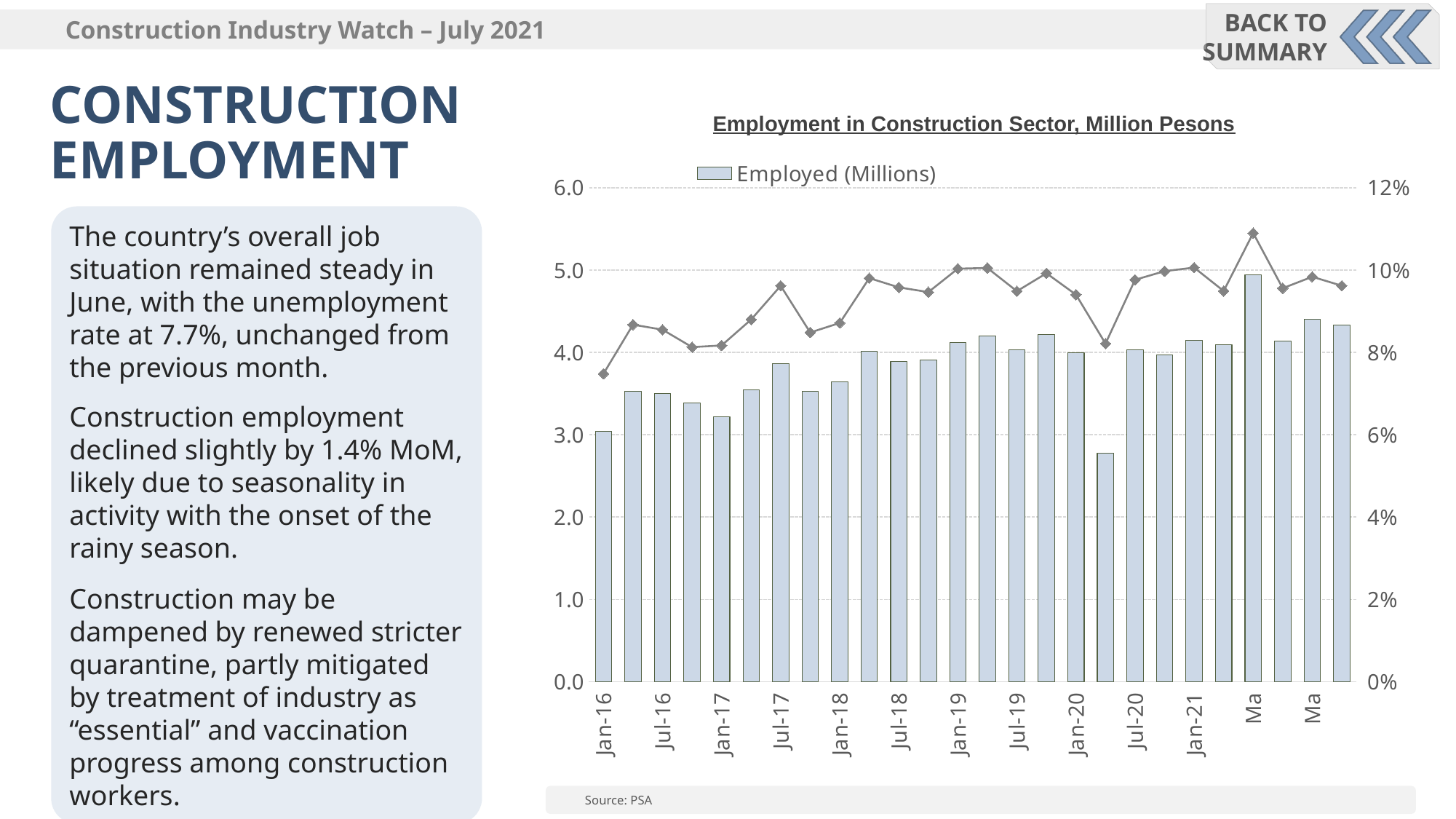
What kind of chart is used to show the Employed (Millions) series? Bar chart How many series does the chart legend list? 1 Is the Employed (Millions) value for Jan-18 greater or less than 4.0? less What is the title of the chart? Employment in Construction Sector, Million Pesons Which has a higher Employed (Millions) value, Jan-16 or Jul-16? Jul-16 Which has a higher Employed (Millions) value, Jan-17 or Jul-17? Jul-17 Is the Employed (Millions) value for Jan-16 greater or less than 4.0? less Do the Employed (Millions) bars generally rise or fall from Jan-16 to Jan-19? Rise Which has a higher Employed (Millions) value, Jan-16 or Jan-21? Jan-21 Is the Employed (Millions) value for Jan-17 greater or less than 3.0? greater What is the name of the series shown in the legend? Employed (Millions)